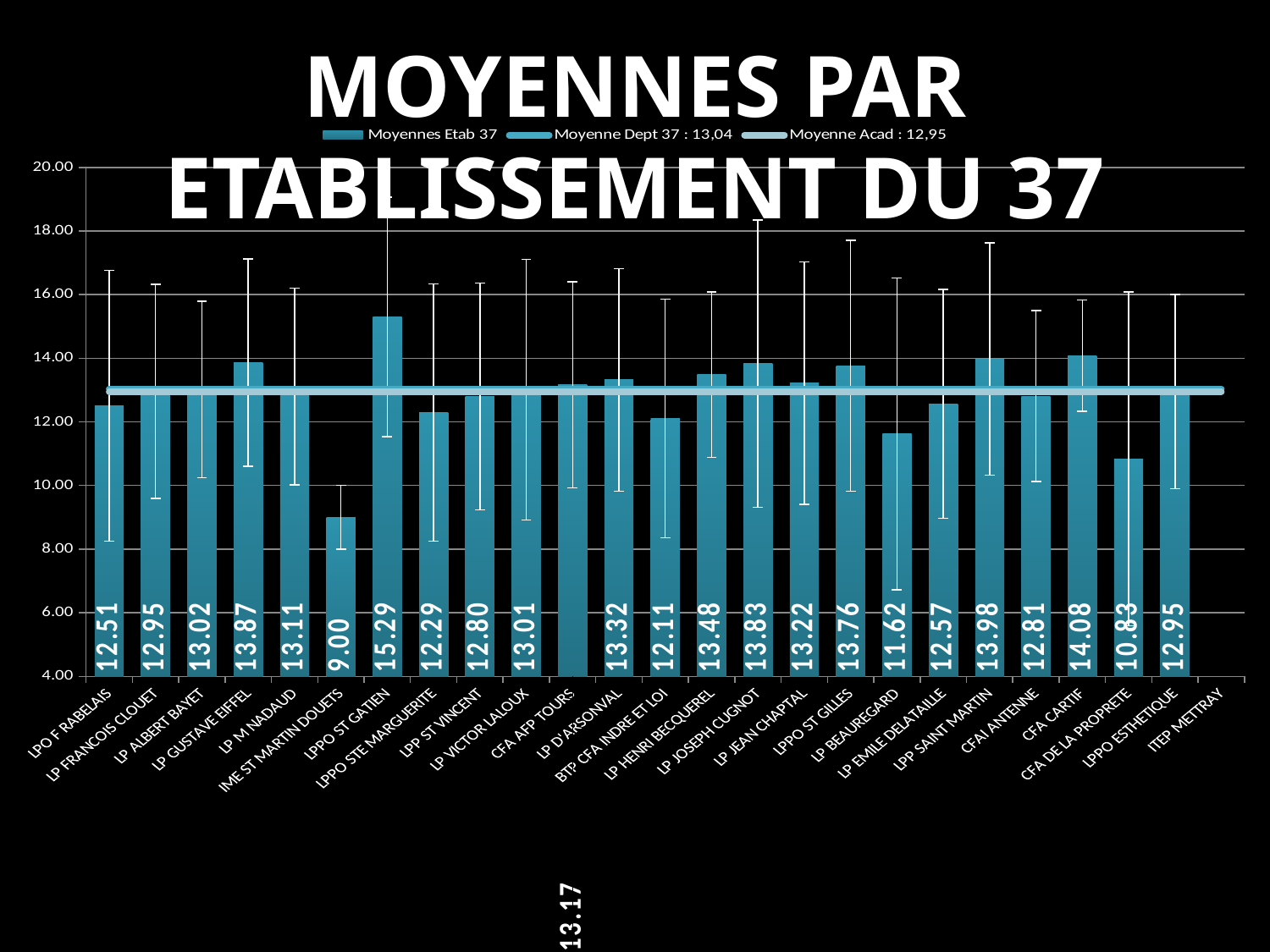
What is the value for IME ST MARTIN DOUETS? 9.00 What is the value for CFA DE LA PROPRETE? 10.83 Which establishment has the highest bar? LPPO ST GATIEN Which establishment has the lowest bar? IME ST MARTIN DOUETS What kind of chart is shown on the slide? combination bar and line chart What is the value for LPPO ST GATIEN? 15.29 What is the value for CFA CARTIF? 14.08 Which is larger, the value for LP GUSTAVE EIFFEL or the value for LP BEAUREGARD? LP GUSTAVE EIFFEL Is the value for LP BEAUREGARD greater or less than 12.00? less According to the legend, what is the value of Moyenne Dept 37? 13,04 How many series does the legend list? 3 What is the difference between the values for LPPO ST GATIEN and IME ST MARTIN DOUETS? 6.29